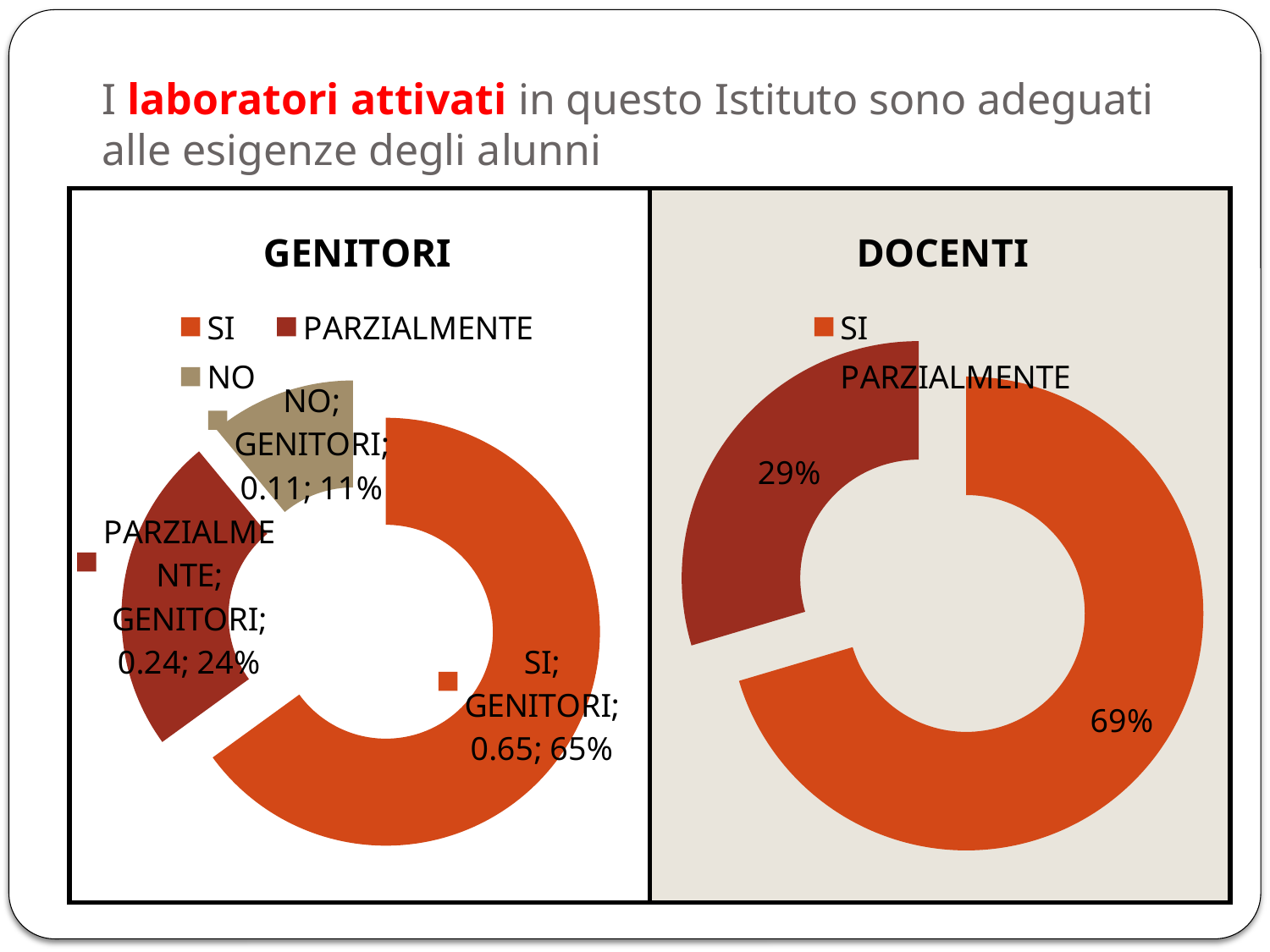
Which is larger: the SI share in the GENITORI chart or the SI share in the DOCENTI chart? DOCENTI In the DOCENTI chart, what percentage is shown for PARZIALMENTE? 29% How many categories does the legend of the GENITORI chart list? 3 In the GENITORI chart, what is the difference in percentage points between SI and PARZIALMENTE? 41 In the GENITORI chart, what percentage is shown for PARZIALMENTE? 24% What kind of chart is the DOCENTI chart? Doughnut (pie) chart In the DOCENTI chart, what percentage is shown for SI? 69% In the DOCENTI chart, what is the difference in percentage points between SI and PARZIALMENTE? 40 In the GENITORI chart, which category has the largest share? SI In the GENITORI chart, which category has the smallest share? NO In the GENITORI chart, what percentage is shown for SI? 65% In the GENITORI chart, what percentage is shown for NO? 11%